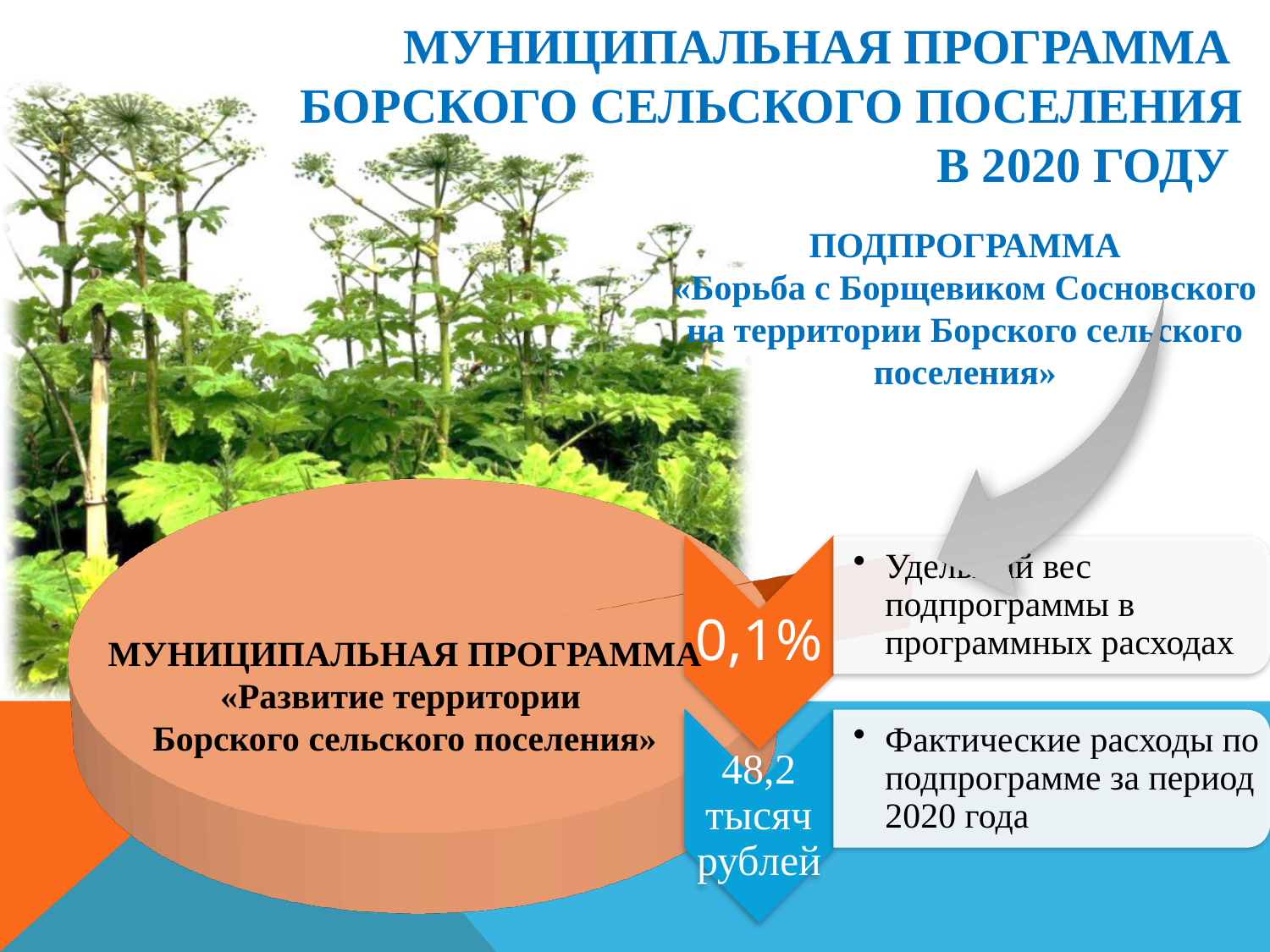
What are the actual expenditures on the subprogramme for 2020 shown next to the pie chart? 48,2 тысяч рублей Which municipal programme is named on the large slice of the pie chart? «Развитие территории Борского сельского поселения» What kind of chart is shown on the slide? pie chart Which is larger in the pie chart: the share of the municipal programme «Развитие территории Борского сельского поселения» or the share of the subprogramme «Борьба с Борщевиком Сосновского»? «Развитие территории Борского сельского поселения» What share of the programme expenditures does the subprogramme «Борьба с Борщевиком Сосновского» account for, according to the slide? 0,1% Is the subprogramme's share of programme expenditures (0,1%) greater or less than 1%? less What colour is the large slice of the pie chart? orange (peach)